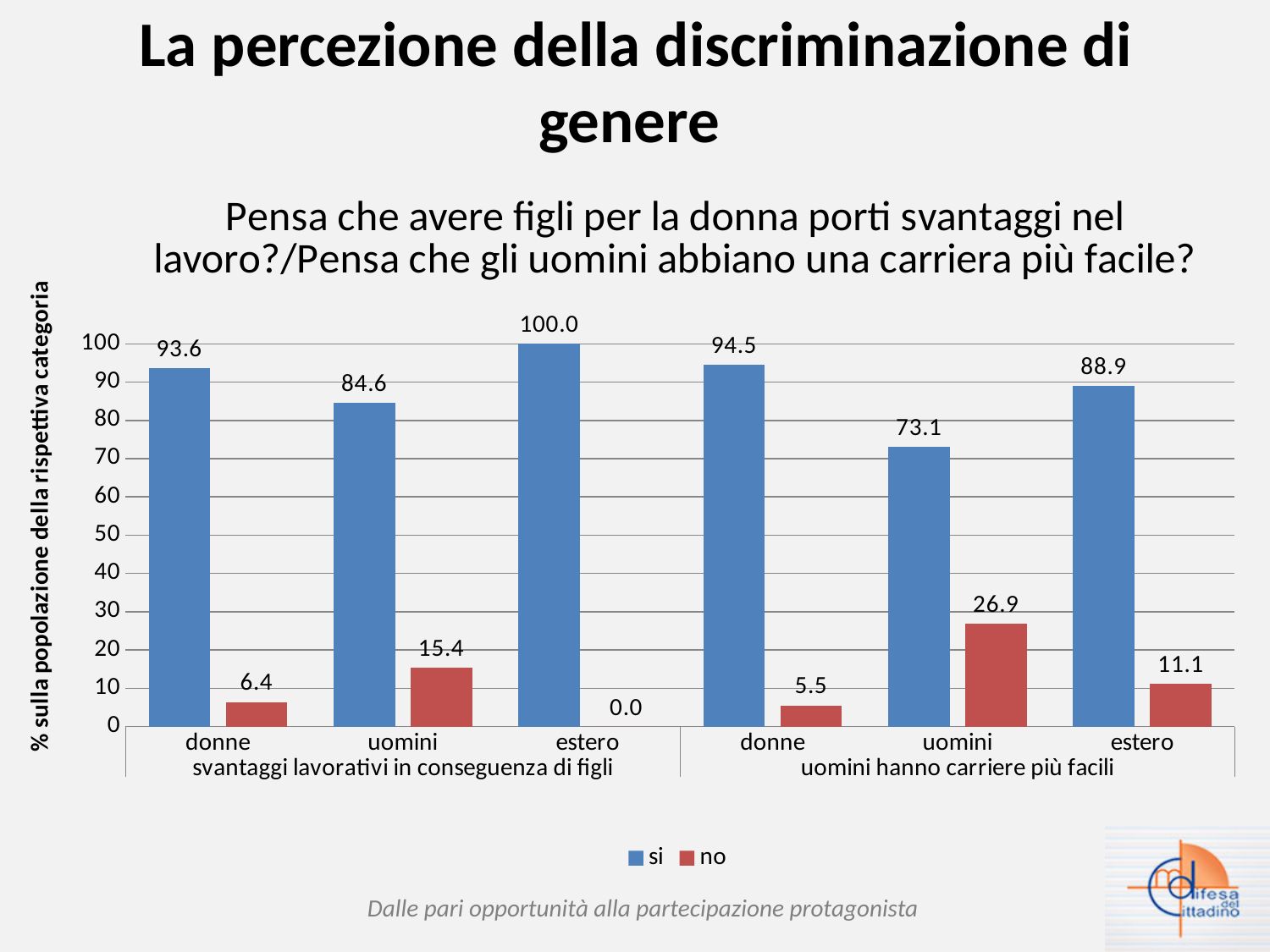
Which category has the highest 'si' value across the whole chart? estero (svantaggi lavorativi in conseguenza di figli) Which category has the lowest 'si' value across the whole chart? uomini (uomini hanno carriere più facili) Which is larger: the 'no' value for uomini under 'svantaggi lavorativi in conseguenza di figli' or the 'no' value for uomini under 'uomini hanno carriere più facili'? uomini under 'uomini hanno carriere più facili' (26.9) What is the 'no' value for estero under 'uomini hanno carriere più facili'? 11.1 What is the difference between the 'si' values for donne and uomini under 'uomini hanno carriere più facili'? 21.4 What is the 'si' value for estero under 'svantaggi lavorativi in conseguenza di figli'? 100.0 What is the 'no' value for uomini under 'uomini hanno carriere più facili'? 26.9 What kind of chart is shown on the slide? bar chart How many series does the legend list? 2 What is the y-axis label of the chart? % sulla popolazione della rispettiva categoria What is the 'si' value for donne under 'svantaggi lavorativi in conseguenza di figli'? 93.6 How many category groups are shown along the x axis? 2